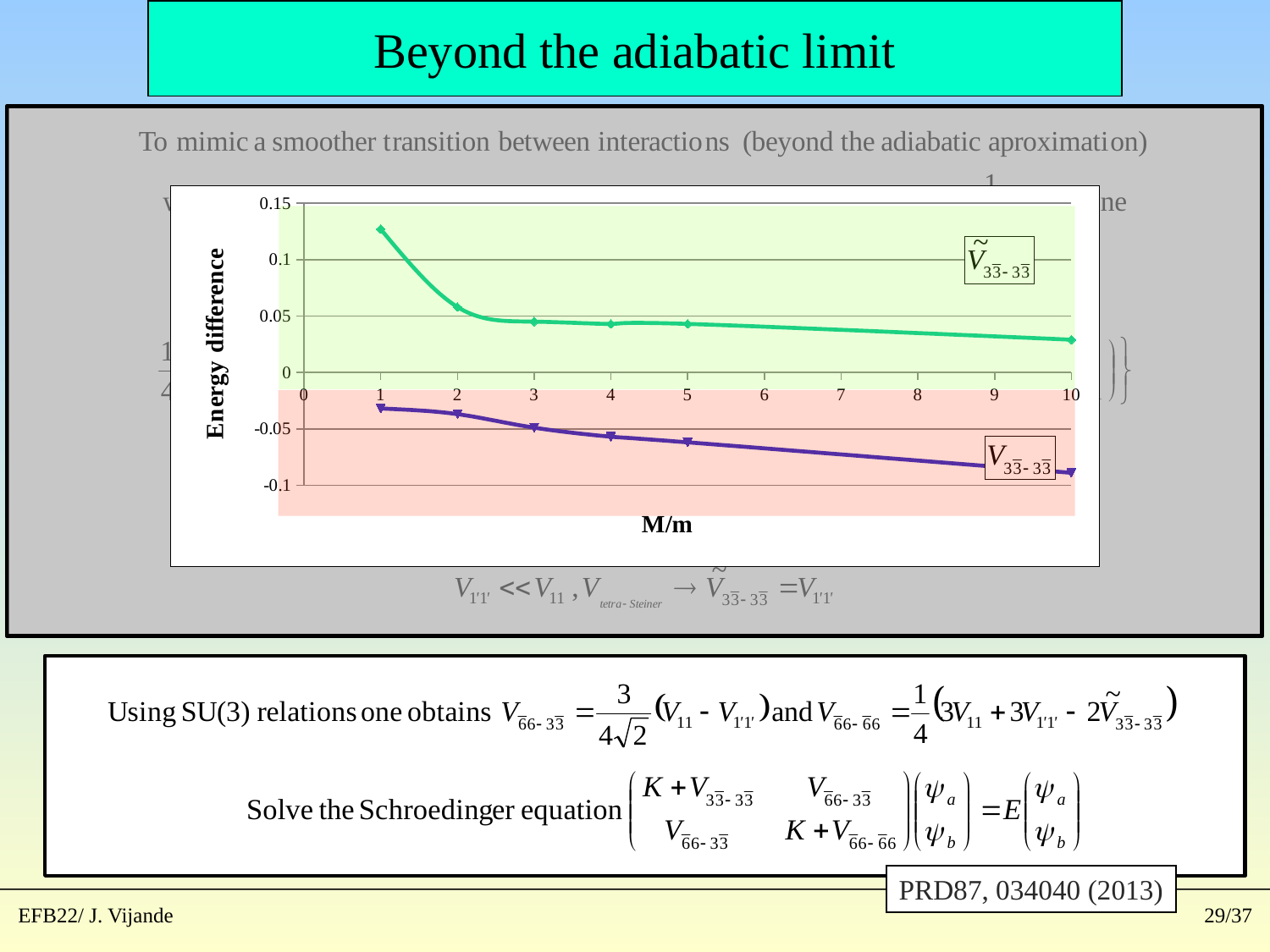
Is the value of the upper (green) series at M/m = 1 greater or less than 0.1? greater Is the value of the lower (blue) series at M/m = 1 greater or less than -0.05? greater Is the value of the lower (blue) series at M/m = 10 greater or less than -0.05? less Does the lower (blue) series rise or fall as M/m increases? fall How many data series are plotted in the chart? 2 Does the upper (green) series rise or fall as M/m increases? fall What type of chart is shown on the slide? line chart What is the label of the x axis of the chart? M/m At which M/m value does the upper (green) series reach its highest point? 1 At which M/m value does the lower (blue) series reach its lowest point? 10 What is the label of the y axis of the chart? Energy difference